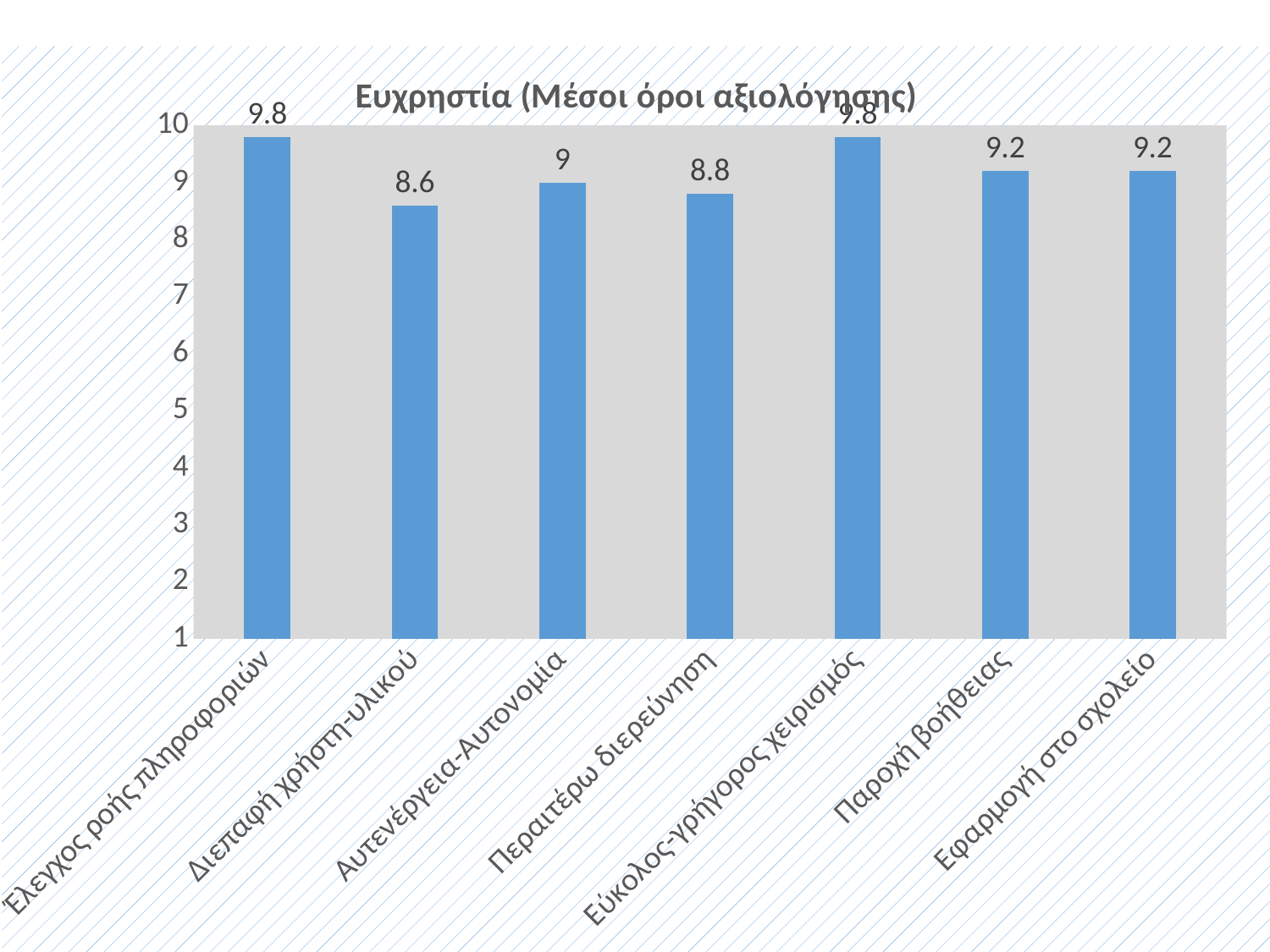
What is the highest value shown in the chart? 9.8 What kind of chart is shown on the slide? Bar chart How many categories are shown in the chart? 7 What is the difference between the values for Έλεγχος ροής πληροφοριών and Διεπαφή χρήστη-υλικού? 1.2 What is the value for Διεπαφή χρήστη-υλικού? 8.6 Is the value for Εύκολος-γρήγορος χειρισμός greater or less than 9? greater Which category has the lowest value? Διεπαφή χρήστη-υλικού What is the value for Περαιτέρω διερεύνηση? 8.8 What is the value for Αυτενέργεια-Αυτονομία? 9 Which is larger, the value for Εφαρμογή στο σχολείο or the value for Περαιτέρω διερεύνηση? Εφαρμογή στο σχολείο What is the value for Παροχή βοήθειας? 9.2 What is the title of the chart? Ευχρηστία (Μέσοι όροι αξιολόγησης)